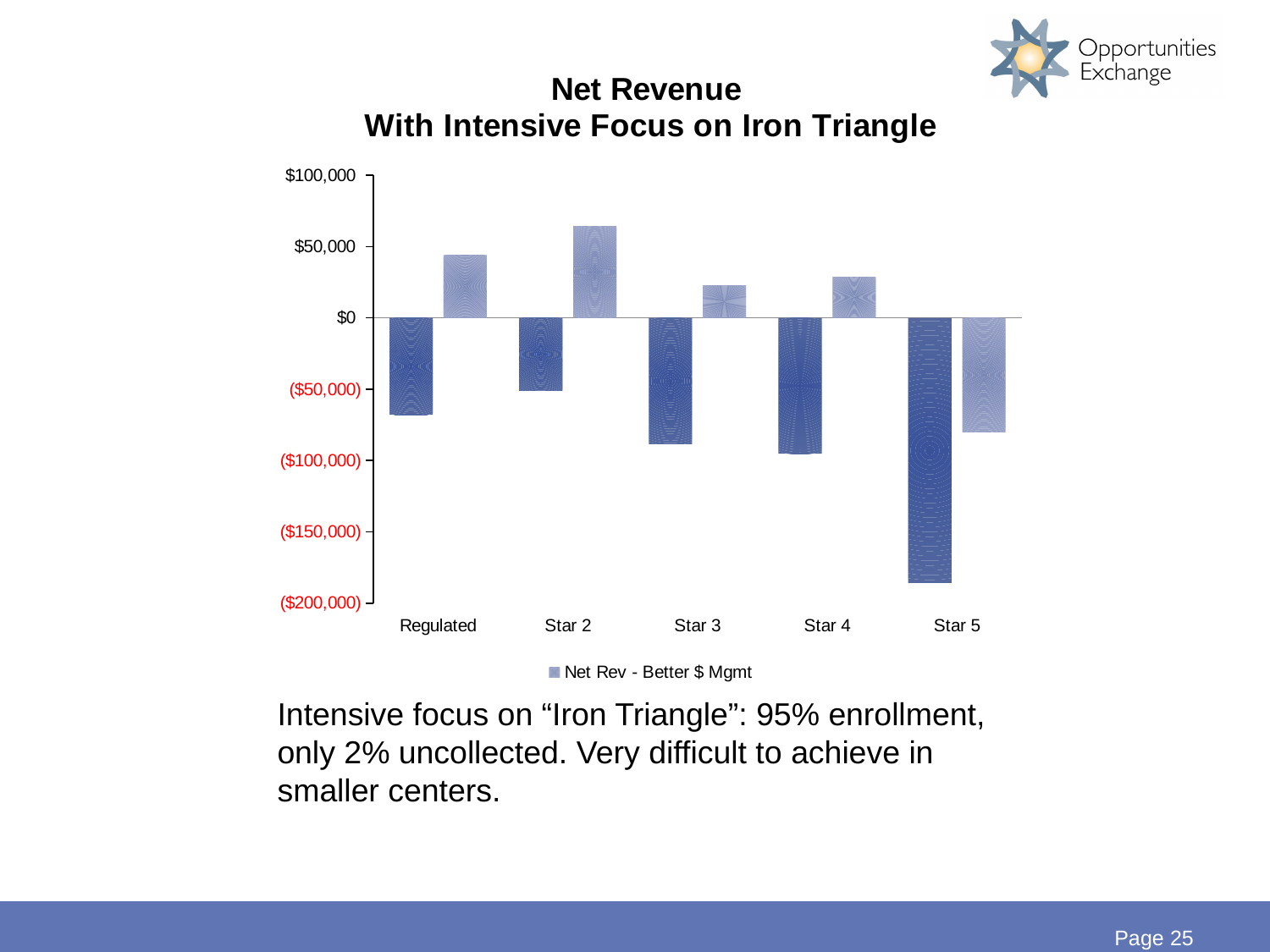
How many categories are shown on the x axis of the chart? 5 What kind of chart is shown on the slide? Bar chart Is the value of the darker (left) bar for Star 5 greater or less than ($150,000)? less Which category has the highest bar in the chart? Star 2 Which is larger, the lighter (right) bar for Star 2 or the lighter (right) bar for Regulated? Star 2 Is the value of the darker (left) bar for Star 3 greater or less than ($50,000)? less How many series does the chart legend list? 1 Is the value of the lighter (right) bar for Regulated greater or less than $50,000? less What is the title of the chart? Net Revenue With Intensive Focus on Iron Triangle Which category has the lowest (most negative) bar in the chart? Star 5 What is the legend entry shown below the chart? Net Rev - Better $ Mgmt